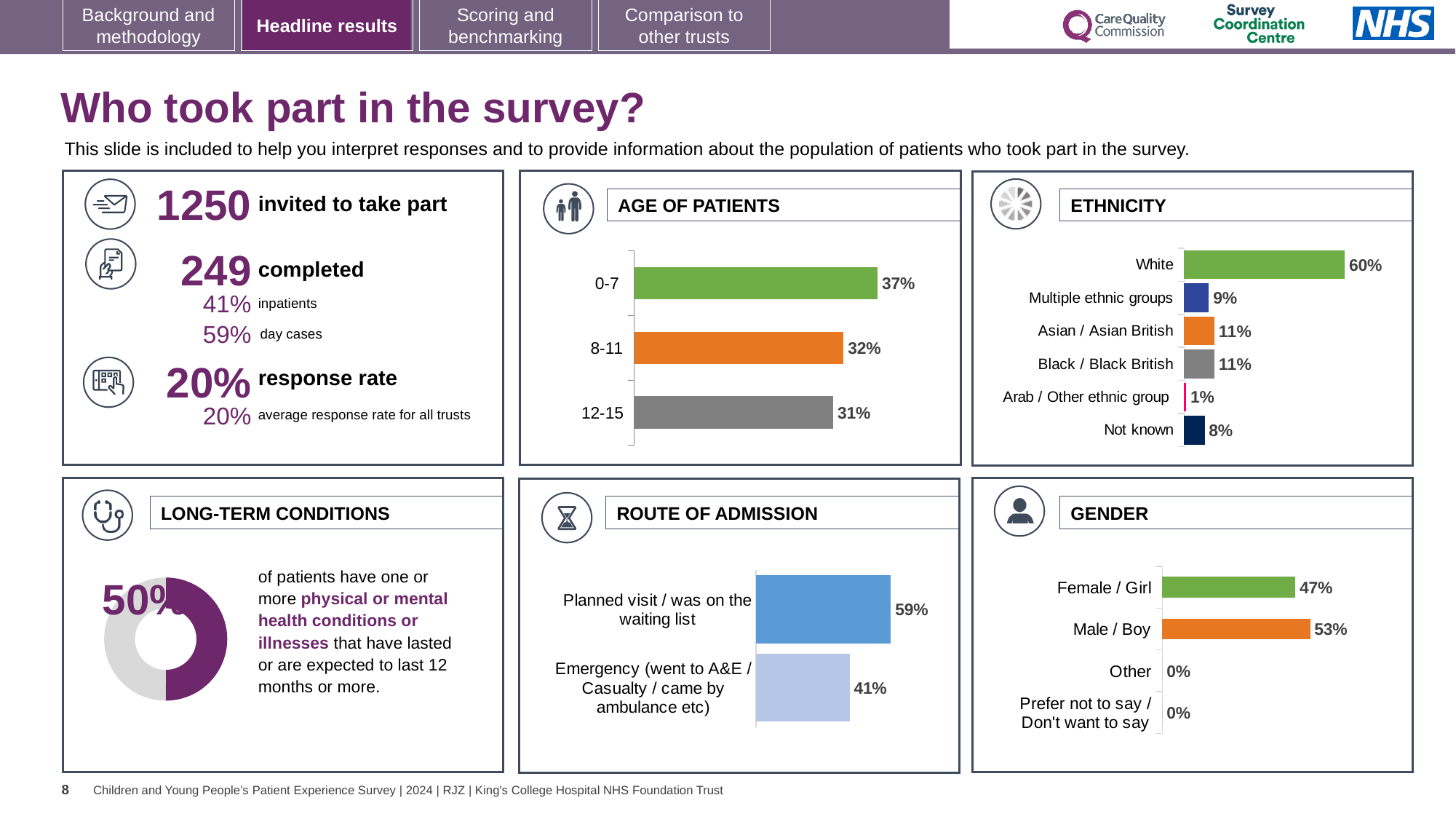
In the GENDER chart, which is larger: Female / Girl or Male / Boy? Male / Boy In the ROUTE OF ADMISSION chart, what percentage of patients had a planned visit / were on the waiting list? 59% In the ETHNICITY chart, which category has the lowest percentage? Arab / Other ethnic group In the AGE OF PATIENTS chart, what is the difference between the 0-7 and 8-11 percentages? 5% In the ETHNICITY chart, which is larger: Multiple ethnic groups or Not known? Multiple ethnic groups In the AGE OF PATIENTS chart, what percentage of patients were aged 0-7? 37% What type of chart is used in the LONG-TERM CONDITIONS panel? Doughnut chart In the ETHNICITY chart, what percentage of patients were White? 60% How many ethnicity categories are shown in the ETHNICITY chart? 6 In the ROUTE OF ADMISSION chart, what is the difference between planned visits and emergency admissions? 18% In the GENDER chart, what percentage of patients were Male / Boy? 53% In the AGE OF PATIENTS chart, which age group has the lowest percentage? 12-15